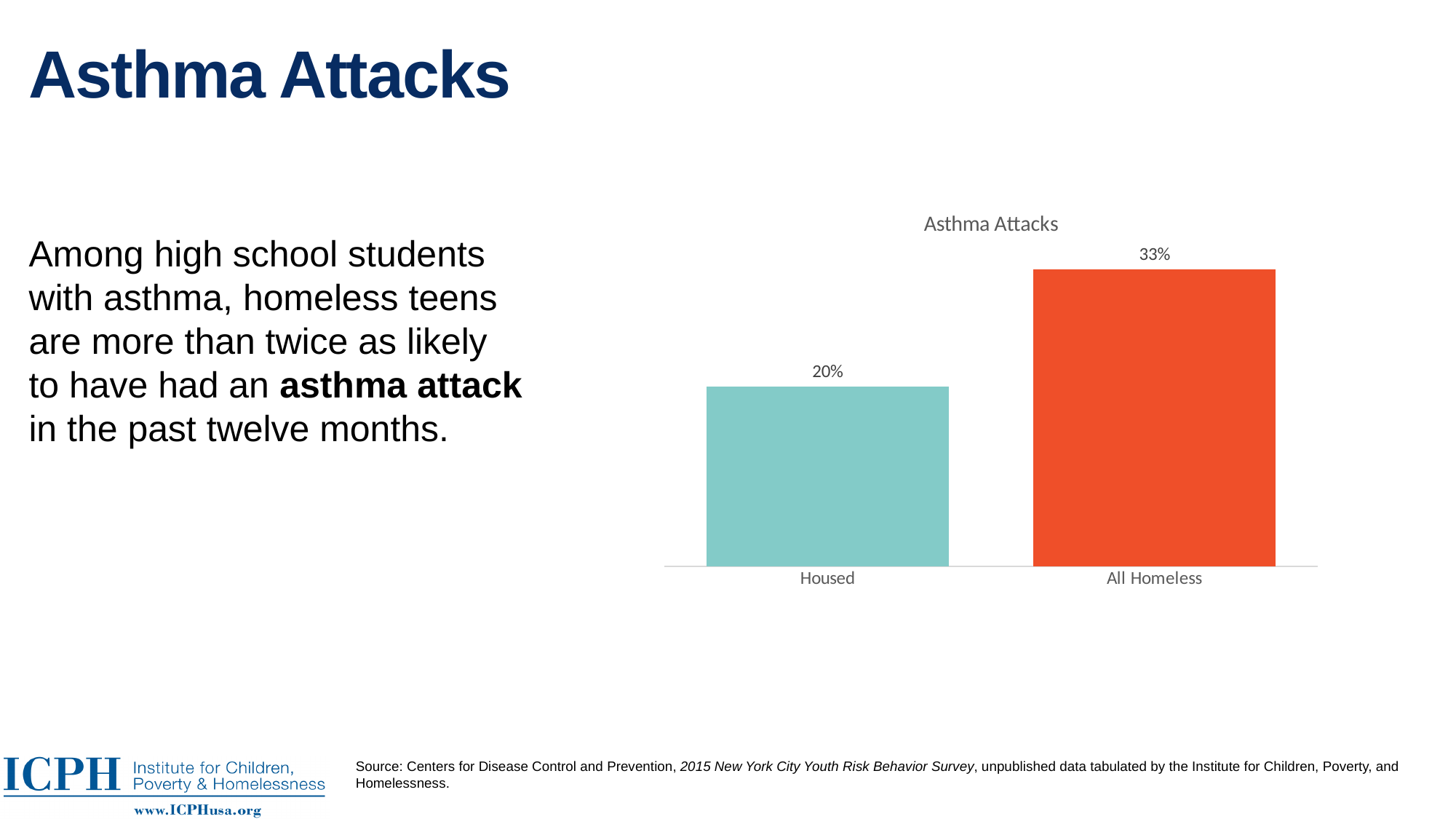
Which category has the lowest value in the Asthma Attacks chart? Housed How many categories are shown in the Asthma Attacks chart? 2 Which is larger in the Asthma Attacks chart, the value for Housed or the value for All Homeless? All Homeless What is the value for Housed in the Asthma Attacks chart? 20% What kind of chart is the Asthma Attacks chart? Bar chart Which category has the highest value in the Asthma Attacks chart? All Homeless What is the title of the chart on the slide? Asthma Attacks What is the difference between the All Homeless and Housed values in the Asthma Attacks chart? 13% What colour is the All Homeless bar in the Asthma Attacks chart? Orange-red What is the value for All Homeless in the Asthma Attacks chart? 33%